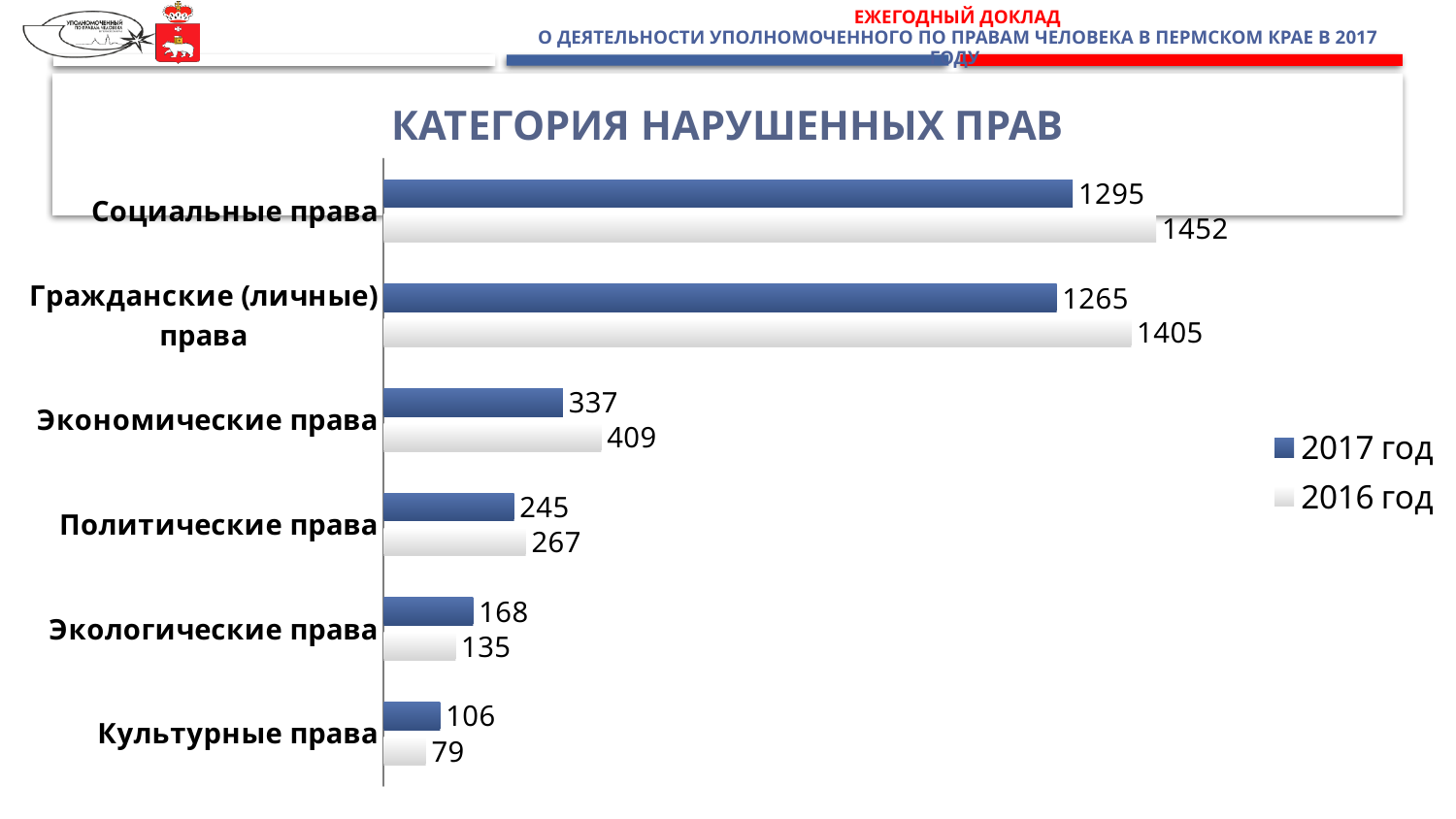
What is the difference between the 2017 год and 2016 год values for Экологические права? 33 What is the value for Культурные права in 2017 год? 106 What kind of chart is shown on the slide? Bar chart Which category has the lowest value in 2017 год? Культурные права What is the difference between the 2016 год and 2017 год values for Социальные права? 157 How many series does the legend list? 2 What is the value for Социальные права in 2017 год? 1295 What is the value for Экономические права in 2016 год? 409 Which category has the highest value in 2016 год? Социальные права What is the title of the chart? КАТЕГОРИЯ НАРУШЕННЫХ ПРАВ Which is larger for Политические права: the 2017 год value or the 2016 год value? 2016 год How many categories are shown on the chart? 6